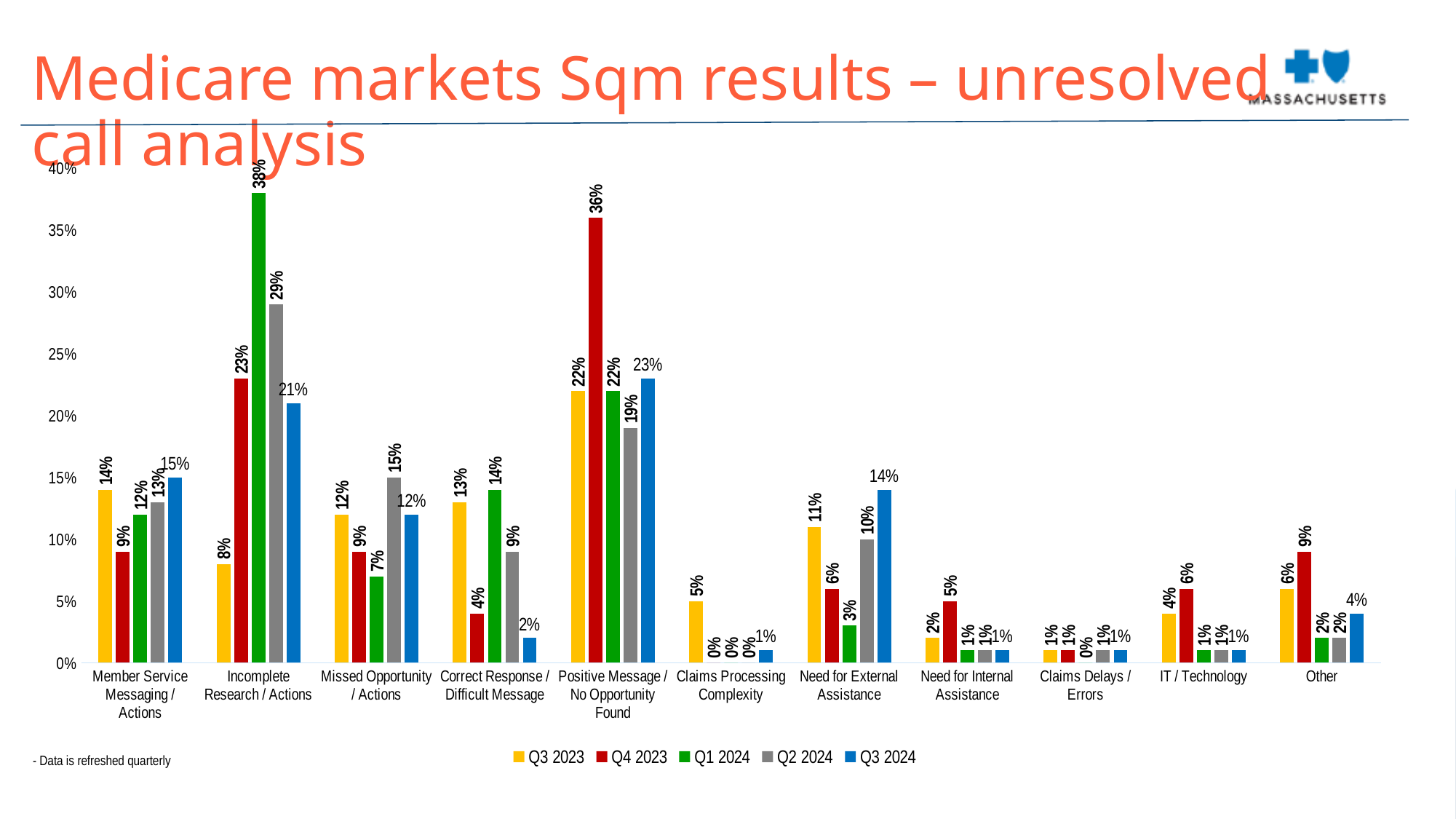
Which category has the highest Q3 2024 value? Positive Message / No Opportunity Found How many categories are shown on the x axis? 11 What kind of chart is shown on the slide? Bar chart Which series is shown in blue in the legend? Q3 2024 Which category has the lowest Q3 2023 value? Claims Delays / Errors What is the Q3 2024 value for Need for External Assistance? 14% What is the difference between the Q1 2024 and Q3 2024 values for Incomplete Research / Actions? 17% Which is larger for Correct Response / Difficult Message: the Q3 2023 value or the Q1 2024 value? Q1 2024 What is the Q4 2023 value for Positive Message / No Opportunity Found? 36% What is the Q2 2024 value for Missed Opportunity / Actions? 15% What is the Q1 2024 value for Incomplete Research / Actions? 38% How many series does the legend list? 5